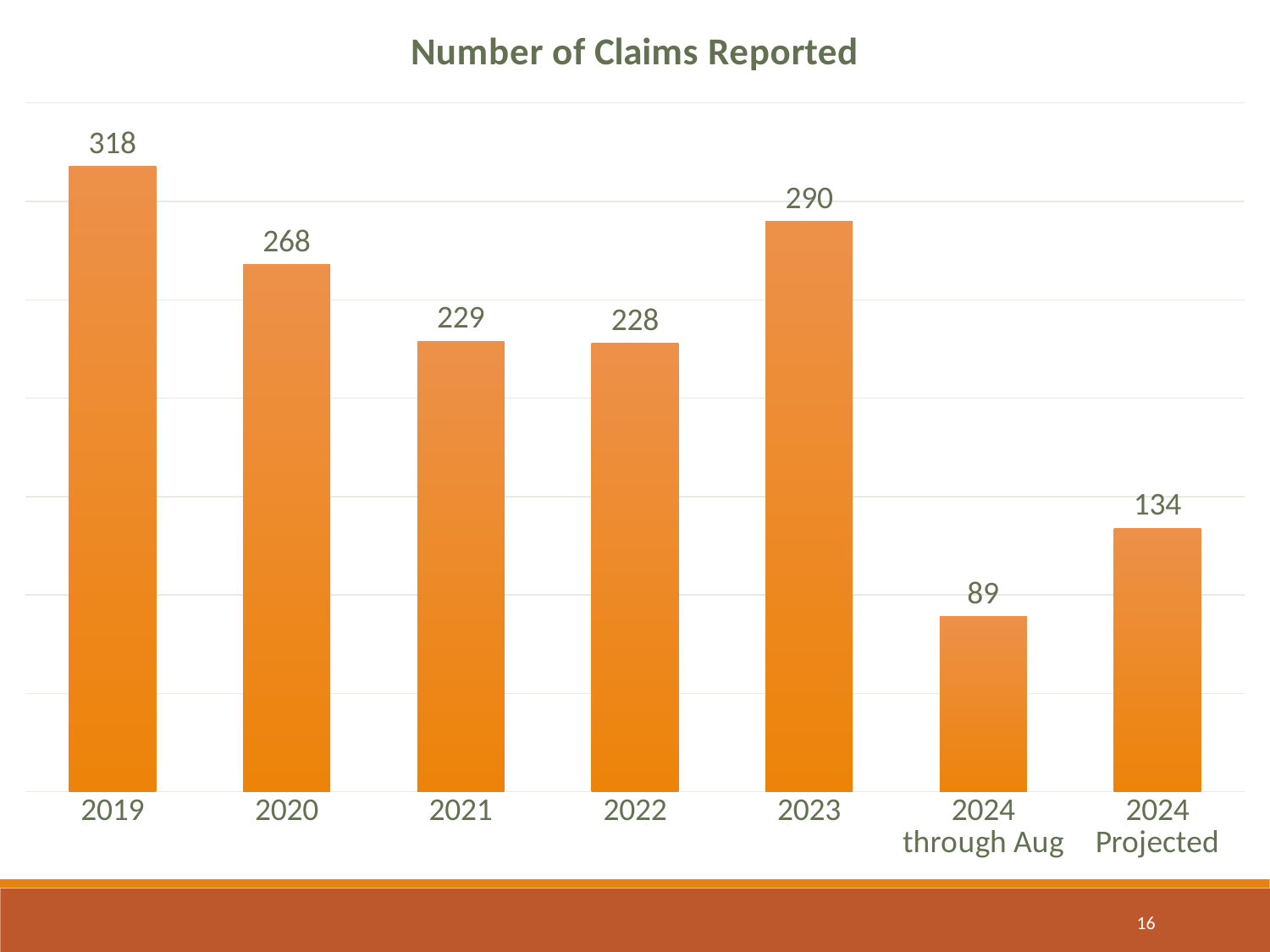
How many categories are shown on the x axis? 7 What is the difference between the 2024 Projected value and the 2024 through Aug value? 45 Which category has the highest number of claims reported? 2019 What is the title of the chart? Number of Claims Reported What is the value for 2024 through Aug? 89 What is the value for 2024 Projected? 134 What is the difference between the number of claims reported in 2019 and 2020? 50 Which category has the lowest number of claims reported? 2024 through Aug What is the number of claims reported in 2023? 290 What kind of chart is shown on the slide? Bar chart What is the number of claims reported in 2019? 318 Which is larger, the number of claims reported in 2020 or in 2023? 2023